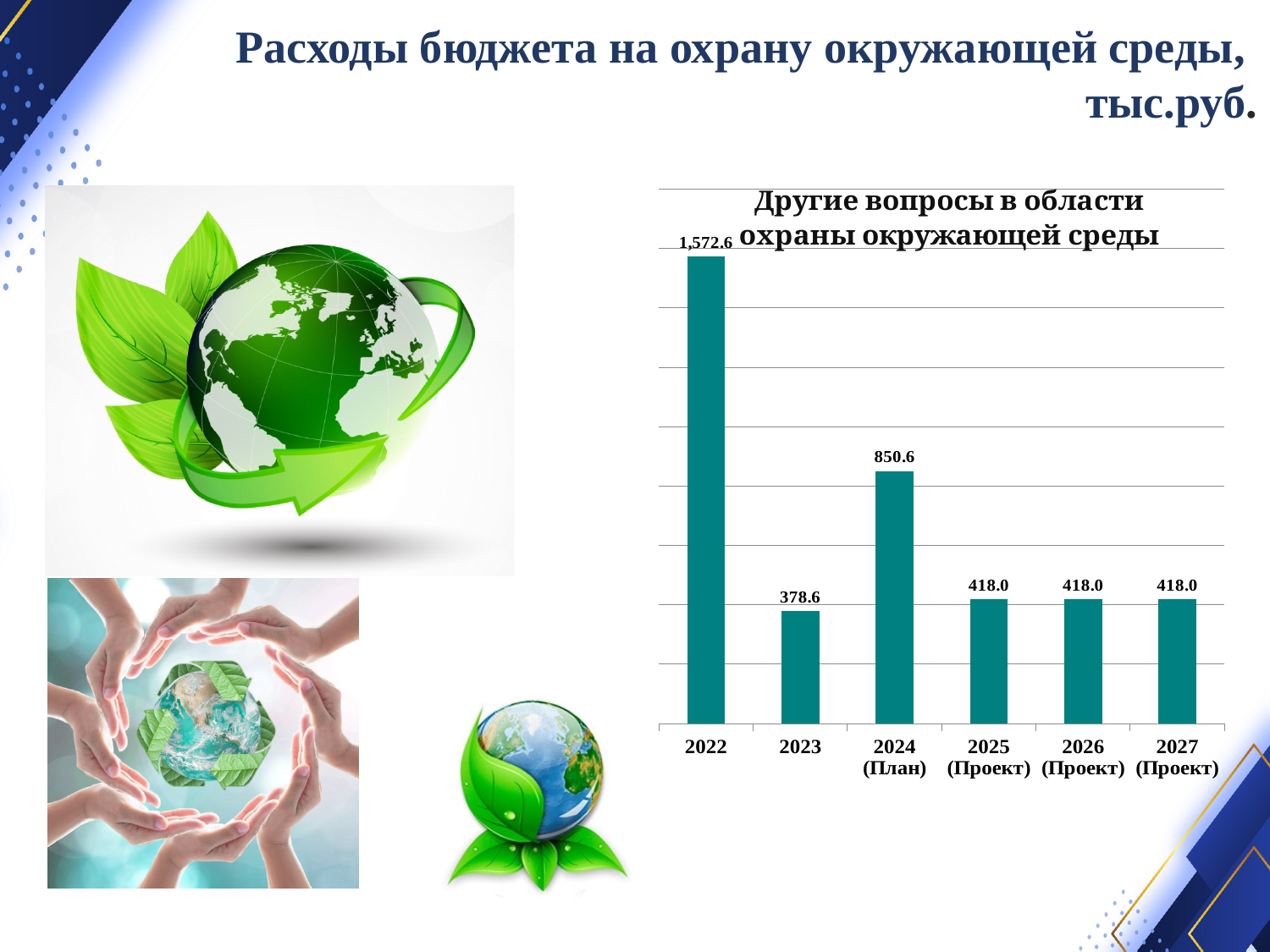
Which year has the lowest value? 2023 Which is larger, the value for 2024 (План) or the value for 2023? 2024 (План) What is the value for 2022? 1,572.6 What is the value for 2023? 378.6 What is the value for 2026 (Проект)? 418.0 Which year has the highest value? 2022 How many categories are shown on the x axis? 6 What is the title of the chart? Другие вопросы в области охраны окружающей среды What kind of chart is shown on the slide? Bar chart What is the difference between the values for 2022 and 2023? 1,194.0 What is the difference between the values for 2024 (План) and 2025 (Проект)? 432.6 What is the value for 2024 (План)? 850.6